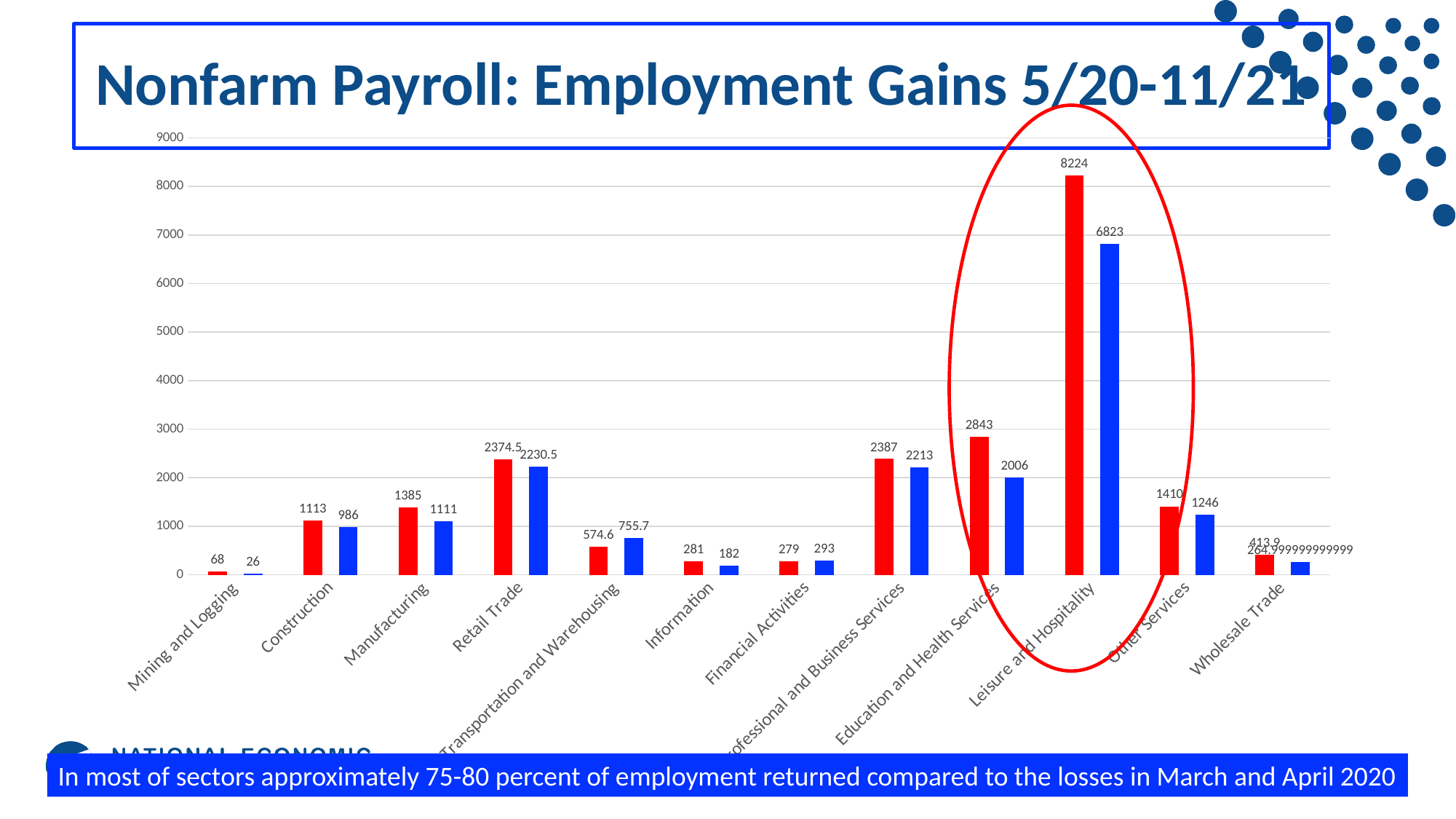
What is the value of the red bar for Leisure and Hospitality? 8224 Is the red bar for Education and Health Services greater or less than 2000? greater For Financial Activities, which bar is larger, the red or the blue? blue Which category has the lowest blue bar? Mining and Logging Which category has the highest red bar? Leisure and Hospitality What is the difference between the red and blue bars for Construction? 127 How many categories are shown on the x axis? 12 What is the value of the red bar for Retail Trade? 2374.5 What is the value of the blue bar for Transportation and Warehousing? 755.7 What is the difference between the red and blue bars for Leisure and Hospitality? 1401 What type of chart is shown on the slide? bar chart What is the value of the blue bar for Education and Health Services? 2006